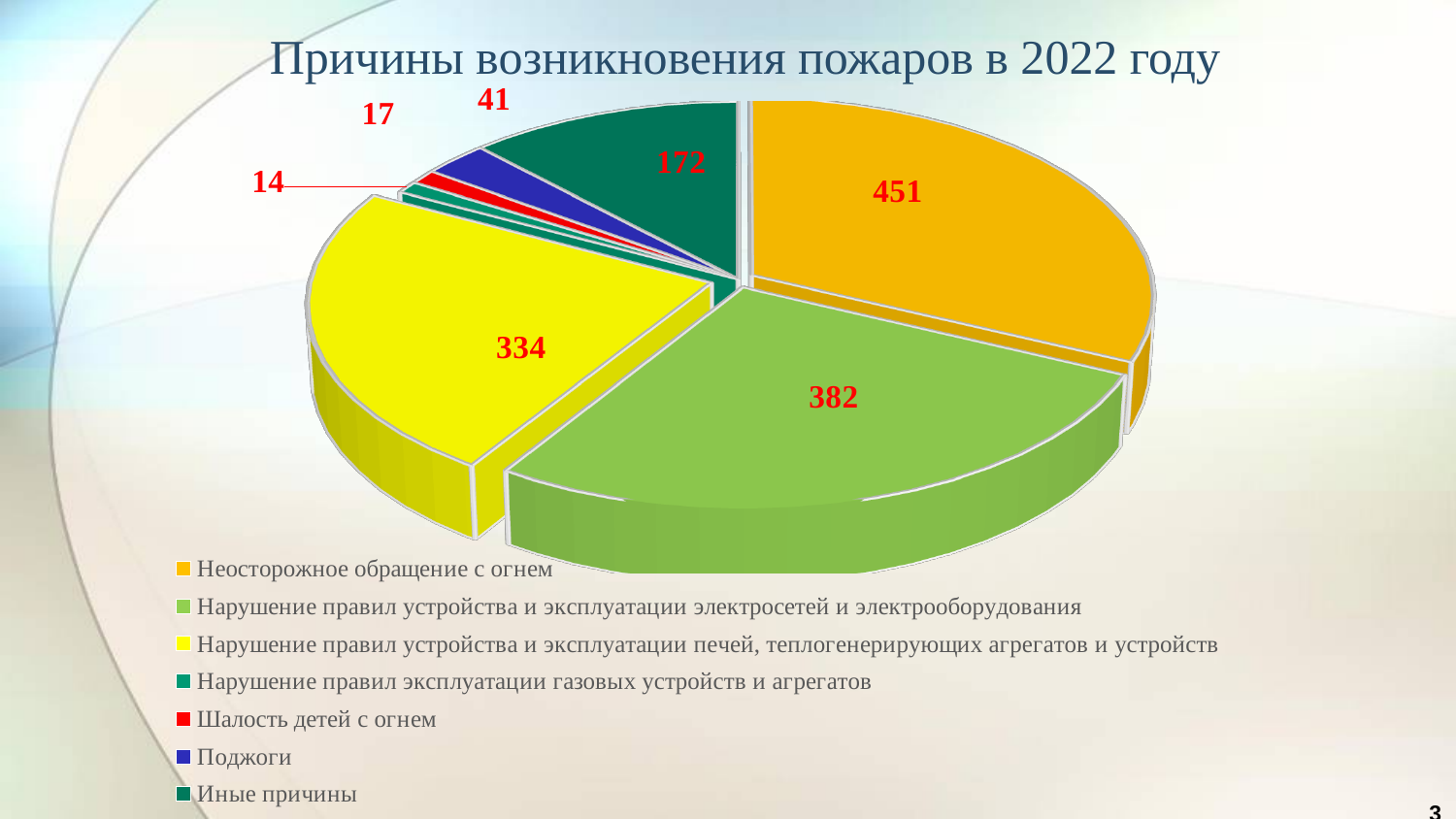
What type of chart is shown on the slide? Pie chart How many categories (slices) does the pie chart have? 7 What is the value for "Иные причины"? 172 Which category has the largest value? Неосторожное обращение с огнем What is the value for "Поджоги"? 41 What is the value for "Неосторожное обращение с огнем"? 451 Which category has the smallest value? Нарушение правил эксплуатации газовых устройств и агрегатов What is the value for "Нарушение правил устройства и эксплуатации печей, теплогенерирующих агрегатов и устройств"? 334 What is the value for "Нарушение правил устройства и эксплуатации электросетей и электрооборудования"? 382 What is the difference between the values for "Неосторожное обращение с огнем" and "Нарушение правил устройства и эксплуатации электросетей и электрооборудования"? 69 What is the title of the chart? Причины возникновения пожаров в 2022 году Which is larger: the value for "Шалость детей с огнем" or the value for "Поджоги"? Поджоги